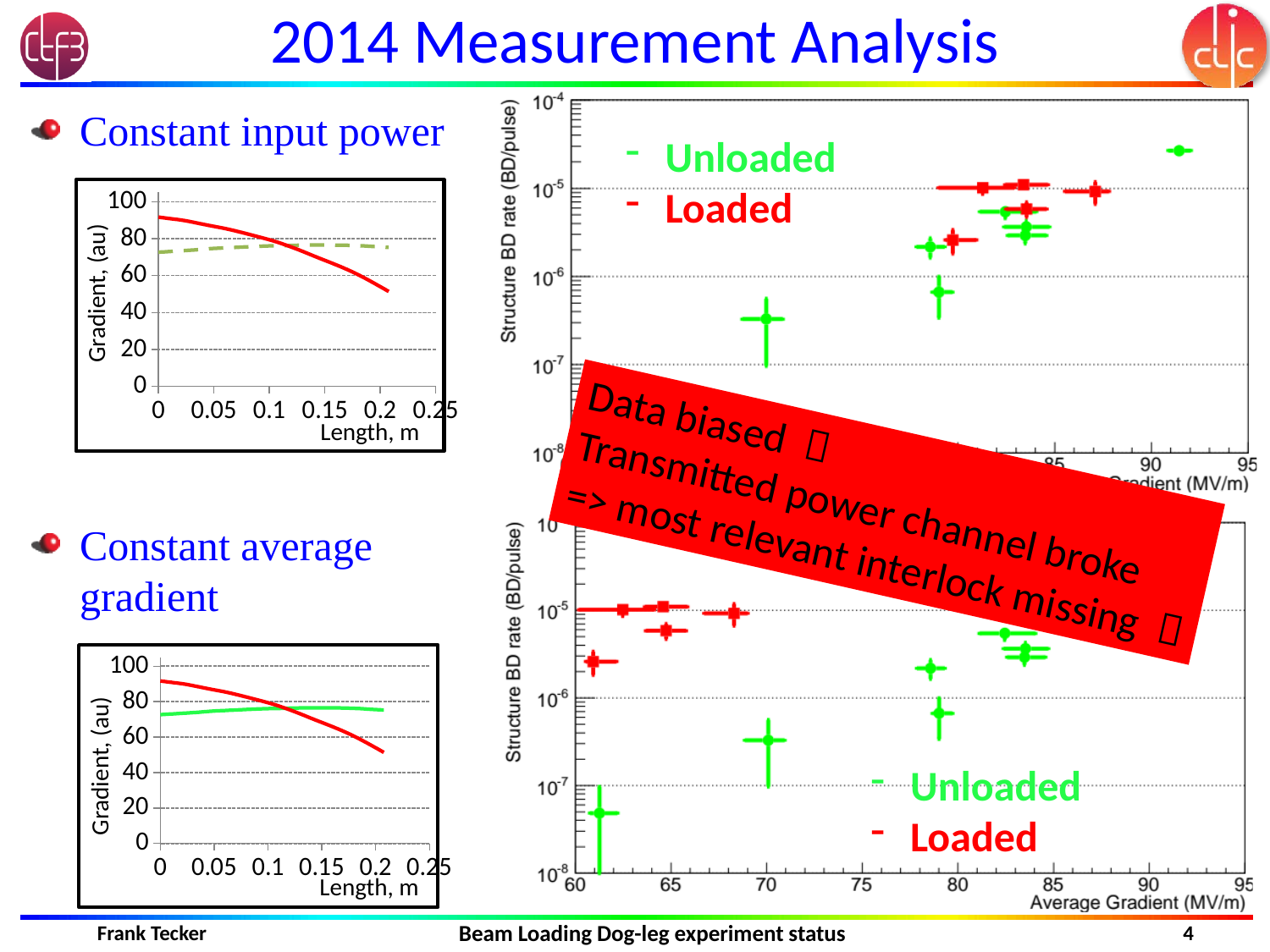
In the top-right chart, is the Structure BD rate of the green point at about 70 MV/m greater or less than 10^-6? less In the bottom-right chart, which series (Unloaded or Loaded) contains the point with the lowest Structure BD rate? Unloaded In the 'Constant average gradient' chart, is the red line's value at its right end (around Length 0.2) greater or less than 60? less In the 'Constant input power' chart, is the red line's value at Length 0 greater or less than 80? greater How many series does the legend of the top-right chart list? 2 What is the x-axis label of the 'Constant average gradient' chart? Length, m How many lines are plotted in the 'Constant average gradient' chart? 2 In the top-right chart, which series (Unloaded or Loaded) contains the point with the highest Structure BD rate? Unloaded What kind of chart is the 'Constant input power' chart on the left of the slide? line chart What kind of chart is the top-right chart with the 'Unloaded' and 'Loaded' legend? scatter plot In the 'Constant input power' chart, does the red line rise or fall as Length increases? fall